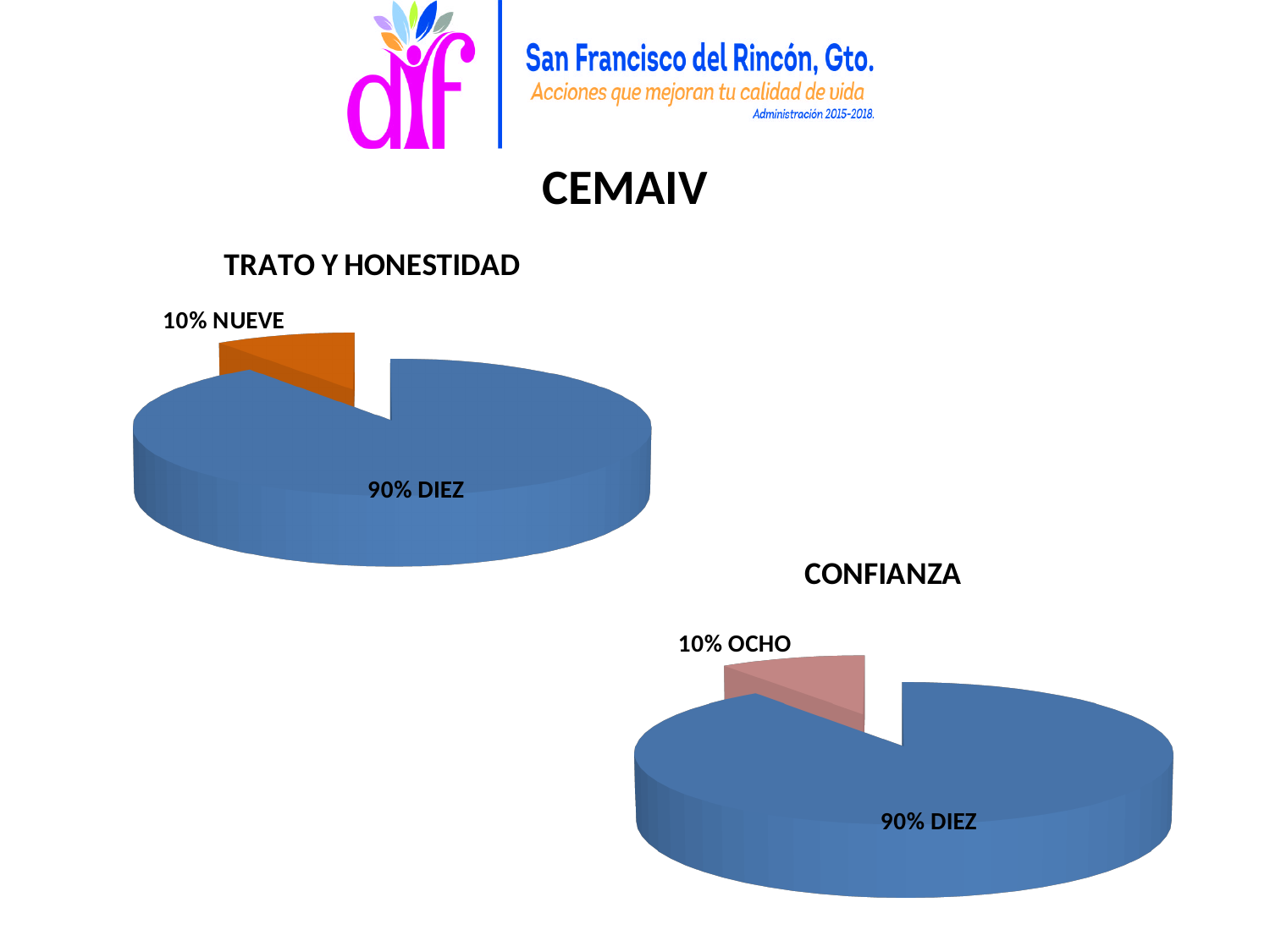
In the 'TRATO Y HONESTIDAD' chart, what is the difference in percentage points between the DIEZ and NUEVE slices? 80 percentage points What is the title of the chart on the lower right of the slide? CONFIANZA What kind of chart is the 'CONFIANZA' chart? Pie chart In the 'TRATO Y HONESTIDAD' chart, what share of the pie is labelled NUEVE? 10% How many slices does the 'TRATO Y HONESTIDAD' pie chart have? 2 In the 'TRATO Y HONESTIDAD' chart, which slice is the largest? DIEZ How many slices does the 'CONFIANZA' pie chart have? 2 In the 'TRATO Y HONESTIDAD' chart, what share of the pie is labelled DIEZ? 90% In the 'CONFIANZA' chart, which slice is the smallest? OCHO In the 'CONFIANZA' chart, what share of the pie is labelled DIEZ? 90% What kind of chart is the 'TRATO Y HONESTIDAD' chart? Pie chart